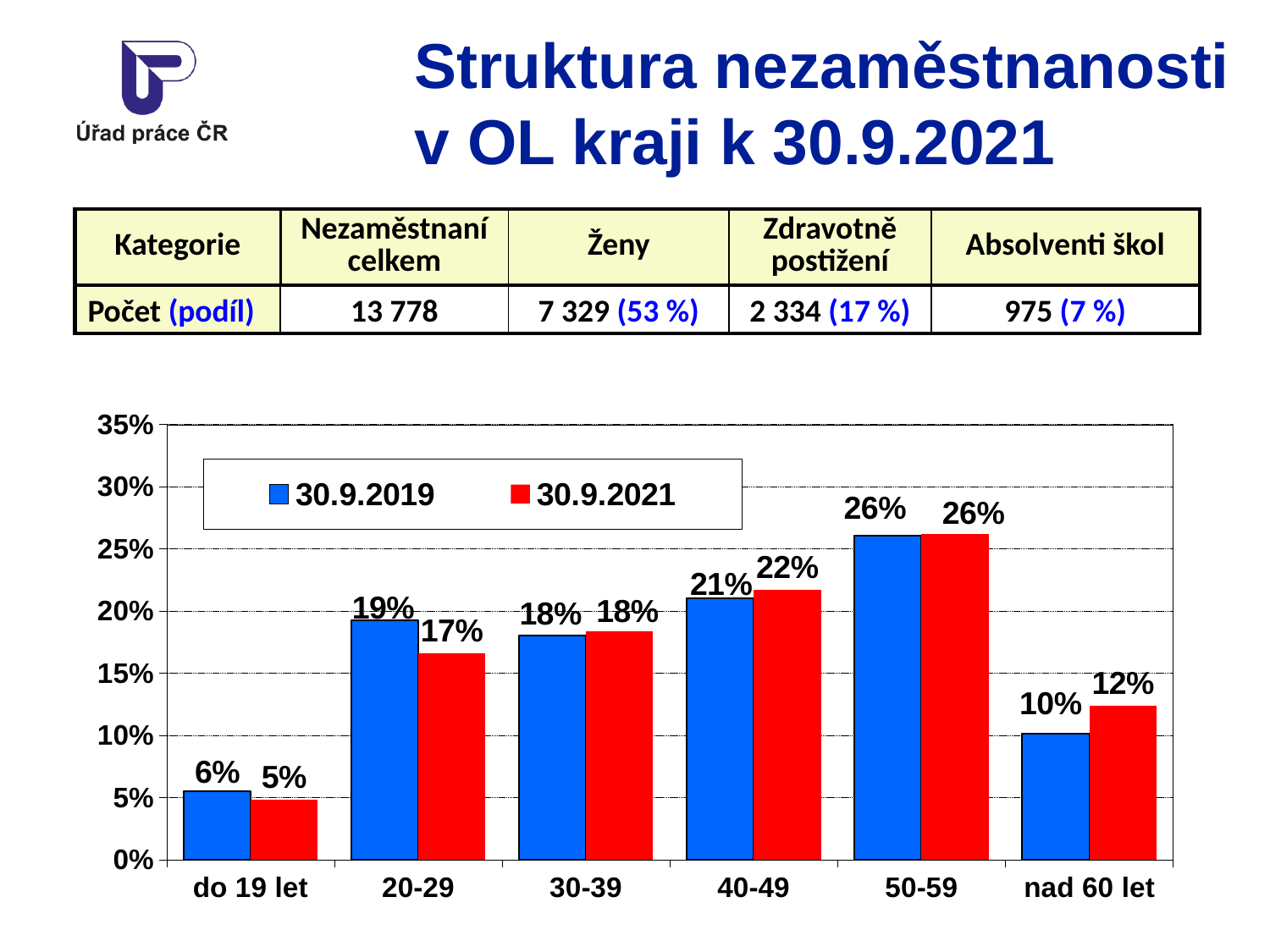
How many series does the chart legend list? 2 For the nad 60 let category, which series has the larger value, 30.9.2019 or 30.9.2021? 30.9.2021 Is the 30.9.2021 value for the 50-59 category greater or less than 25%? greater Which age category has the highest value in the 30.9.2021 series? 50-59 Which colour represents the 30.9.2021 series in the chart? red How many age categories are shown on the x axis of the chart? 6 Which age category has the lowest value in the 30.9.2019 series? do 19 let What type of chart is shown on the slide? bar chart What is the value for the 20-29 category in the 30.9.2021 series? 17% What is the difference between the 30.9.2019 and 30.9.2021 values for the 20-29 category? 2% What is the value for the nad 60 let category in the 30.9.2019 series? 10% What is the value for the 40-49 category in the 30.9.2021 series? 22%